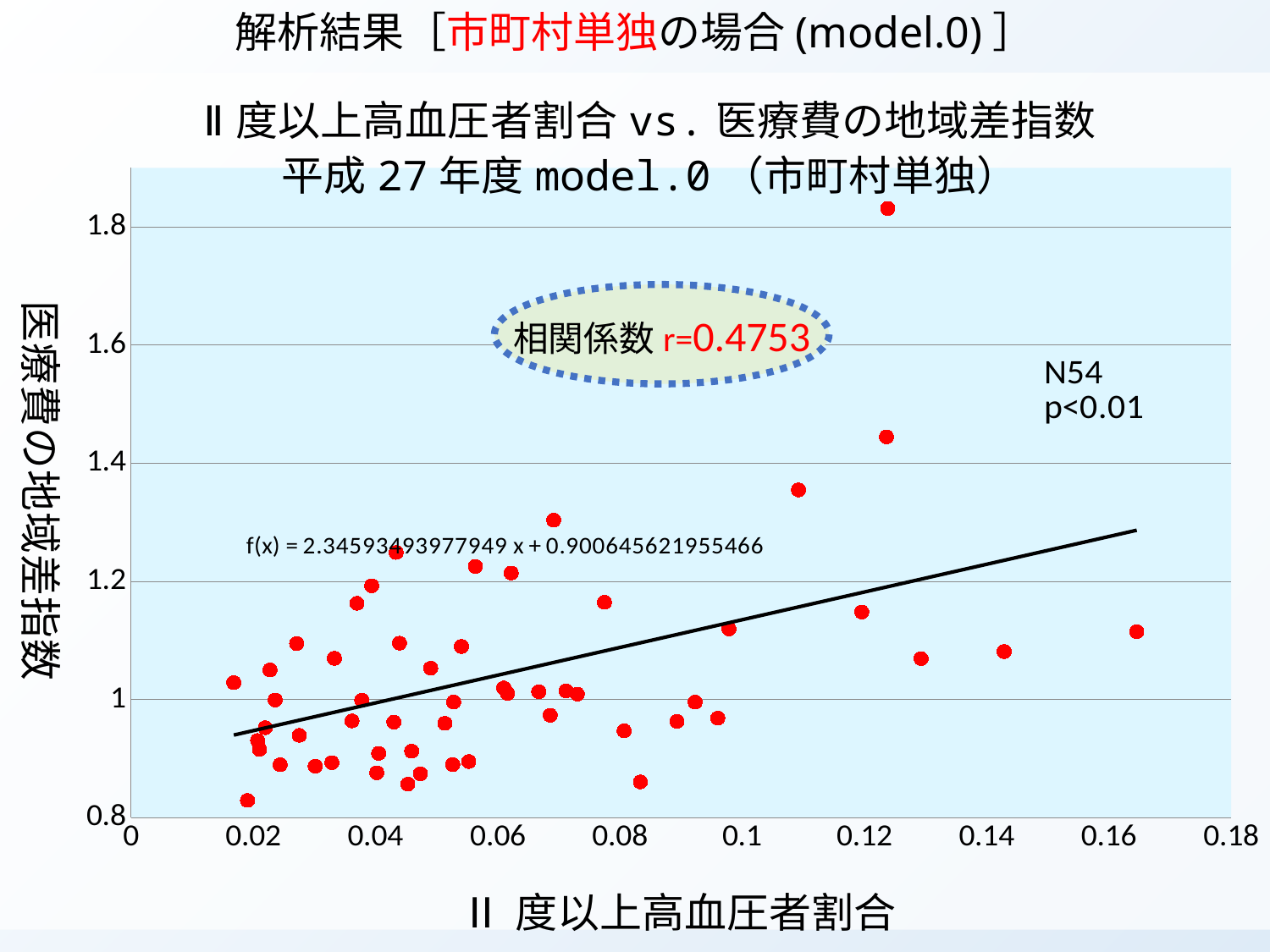
What kind of chart is shown on the slide? scatter chart What p-value is shown on the chart? p<0.01 What is the highest tick value shown on the x axis? 0.18 What is the slope of the fitted line f(x) shown on the chart? 2.34593493977949 What is the intercept of the fitted line f(x) shown on the chart? 0.900645621955466 Is the y value of the point near x = 0.12 that lies above the fitted line greater or less than 1.4? greater How many data points (N) does the chart indicate? 54 Is the y value of the highest plotted point greater or less than 1.8? greater What is the correlation coefficient (相関係数) shown on the chart? r=0.4753 According to the fitted line, do the values of 医療費の地域差指数 rise or fall as Ⅱ度以上高血圧者割合 increases? rise What is the lowest tick value shown on the y axis? 0.8 Is the y value of the point with the largest x value (around 0.165) greater or less than 1.2? less